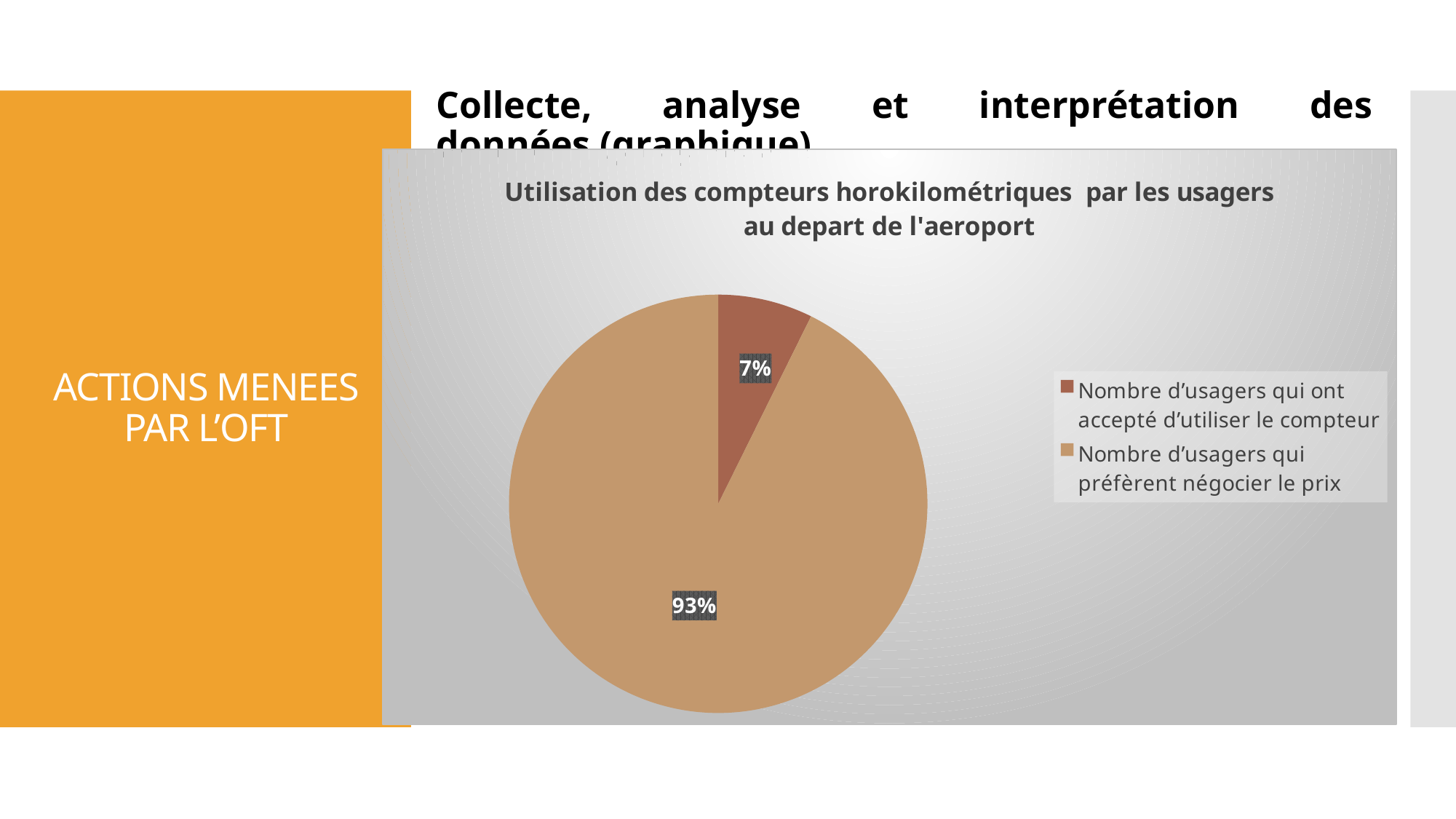
Which category has the smallest slice of the pie? Nombre d'usagers qui ont accepté d'utiliser le compteur What colour is the slice for 'Nombre d'usagers qui ont accepté d'utiliser le compteur'? Dark reddish brown What kind of chart is shown on the slide? Pie chart How many slices does the pie chart have? 2 What share of the pie is labelled for 'Nombre d'usagers qui préfèrent négocier le prix'? 93% What is the difference in percentage points between the two slices of the pie? 86 Which is larger: the share of users who accepted to use the meter or the share of users who prefer to negotiate the price? Nombre d'usagers qui préfèrent négocier le prix How many entries does the legend list? 2 Which category has the largest slice of the pie? Nombre d'usagers qui préfèrent négocier le prix What share of the pie is labelled for 'Nombre d'usagers qui ont accepté d'utiliser le compteur'? 7% What is the title of the chart? Utilisation des compteurs horokilométriques par les usagers au depart de l'aeroport